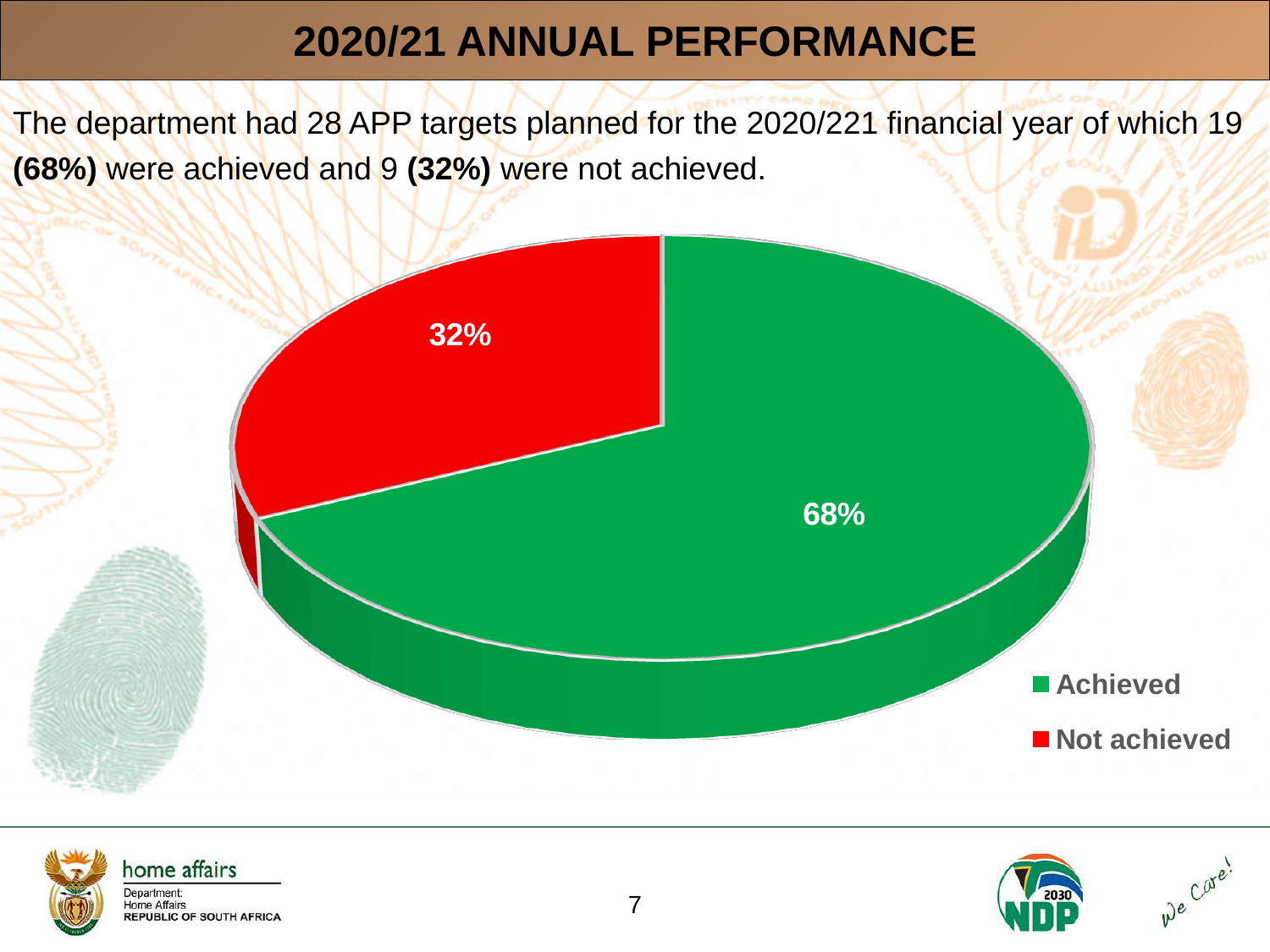
What share of the pie is labelled Achieved? 68% How many entries does the legend list? 2 What kind of chart is shown on the slide? pie chart Which is larger, the Achieved slice or the Not achieved slice? Achieved What colour is the Not achieved slice? red What is the difference in percentage points between the Achieved and Not achieved slices? 36 What colour is the Achieved slice? green Which slice of the pie is the largest? Achieved What share of the pie is labelled Not achieved? 32% How many slices does the pie chart have? 2 Which slice of the pie is the smallest? Not achieved Is the share for Not achieved greater or less than 50%? less